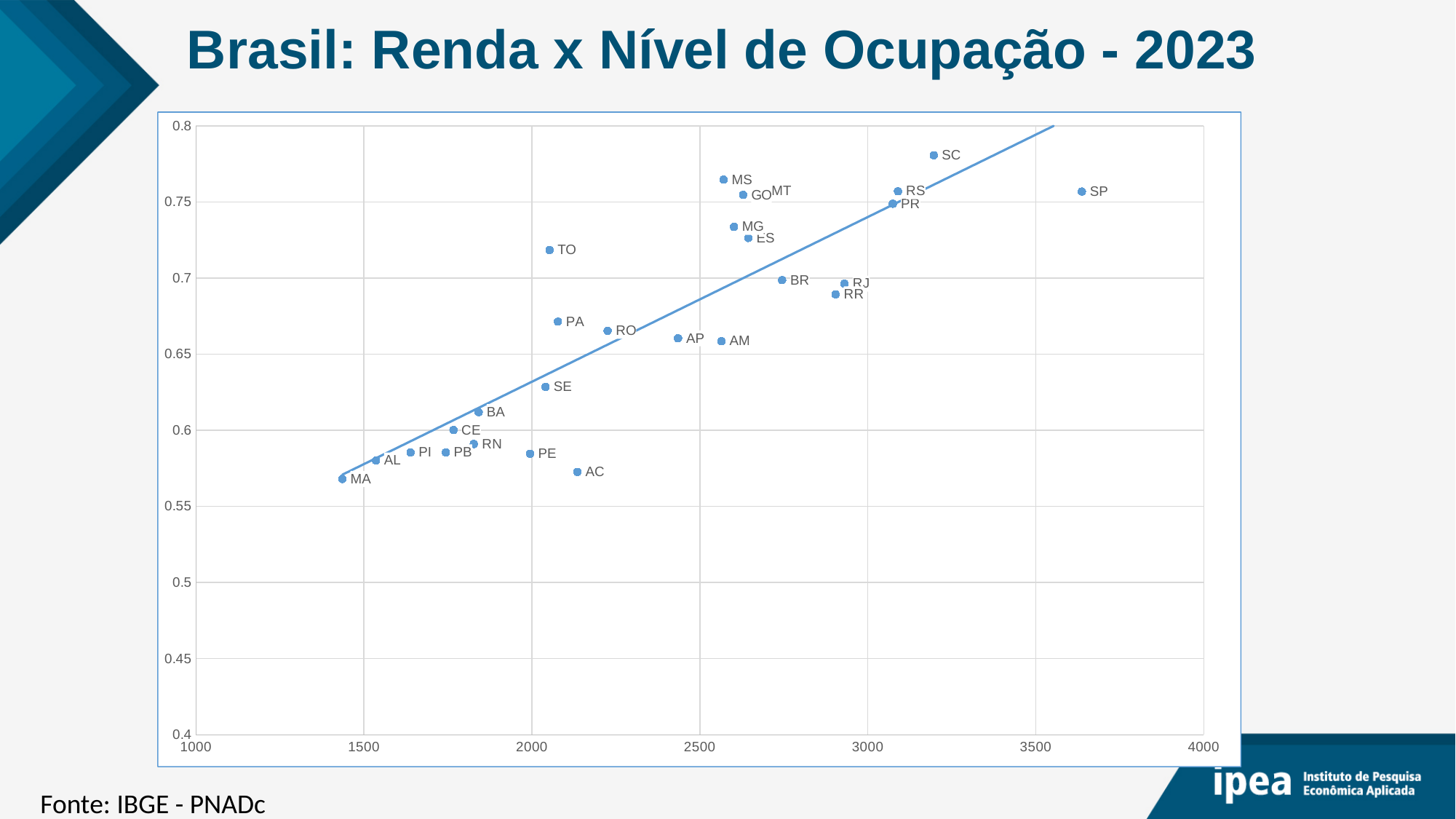
Is the vertical-axis value for AC greater or less than 0.6? less Is the vertical-axis value for TO greater or less than 0.7? greater Do the plotted points generally rise or fall as the horizontal-axis value increases? rise Which labelled point has the highest value on the vertical axis? SC Which point is higher on the vertical axis, TO or PA? TO Is the horizontal-axis value for SP greater or less than 3500? greater Which labelled point is furthest to the right on the horizontal axis? SP What is the title of the chart on the slide? Brasil: Renda x Nível de Ocupação - 2023 Which labelled point has the lowest value on the vertical axis? MA What kind of chart is shown on the slide? scatter chart